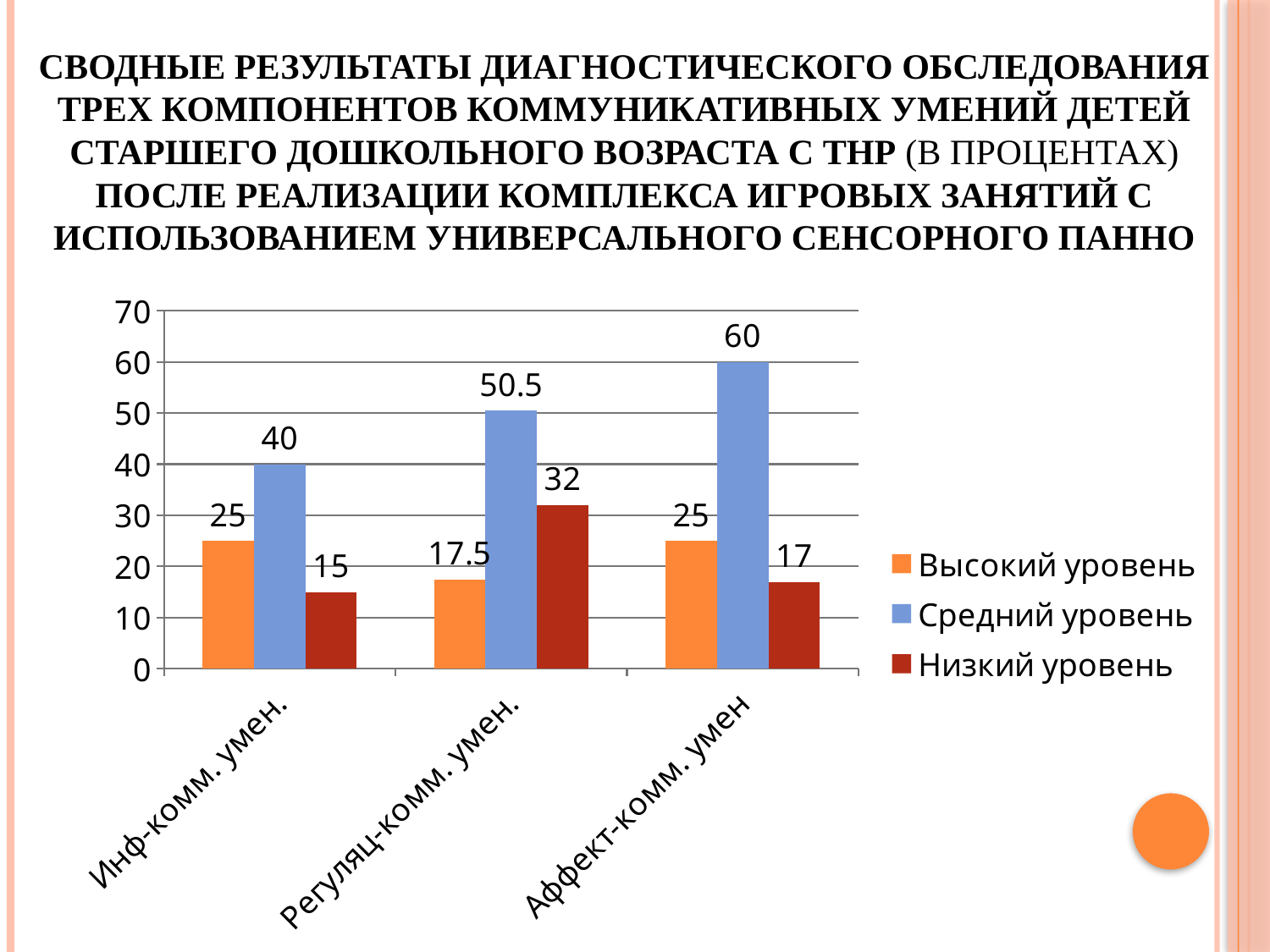
What is the value for Низкий уровень in the Инф-комм. умен. category? 15 What is the value for Средний уровень in the Регуляц-комм. умен. category? 50.5 What is the difference between the Средний уровень and Низкий уровень values in the Регуляц-комм. умен. category? 18.5 Is the value for Средний уровень in the Аффект-комм. умен category greater or less than 50? greater How many series does the legend list? 3 What is the value for Высокий уровень in the Аффект-комм. умен category? 25 Which category has the lowest value for Высокий уровень? Регуляц-комм. умен. Which colour represents Низкий уровень in the legend? dark red Which is larger in the Инф-комм. умен. category: Высокий уровень or Низкий уровень? Высокий уровень What kind of chart is shown on the slide? bar chart How many categories are shown on the x axis? 3 Which category has the highest value for Средний уровень? Аффект-комм. умен